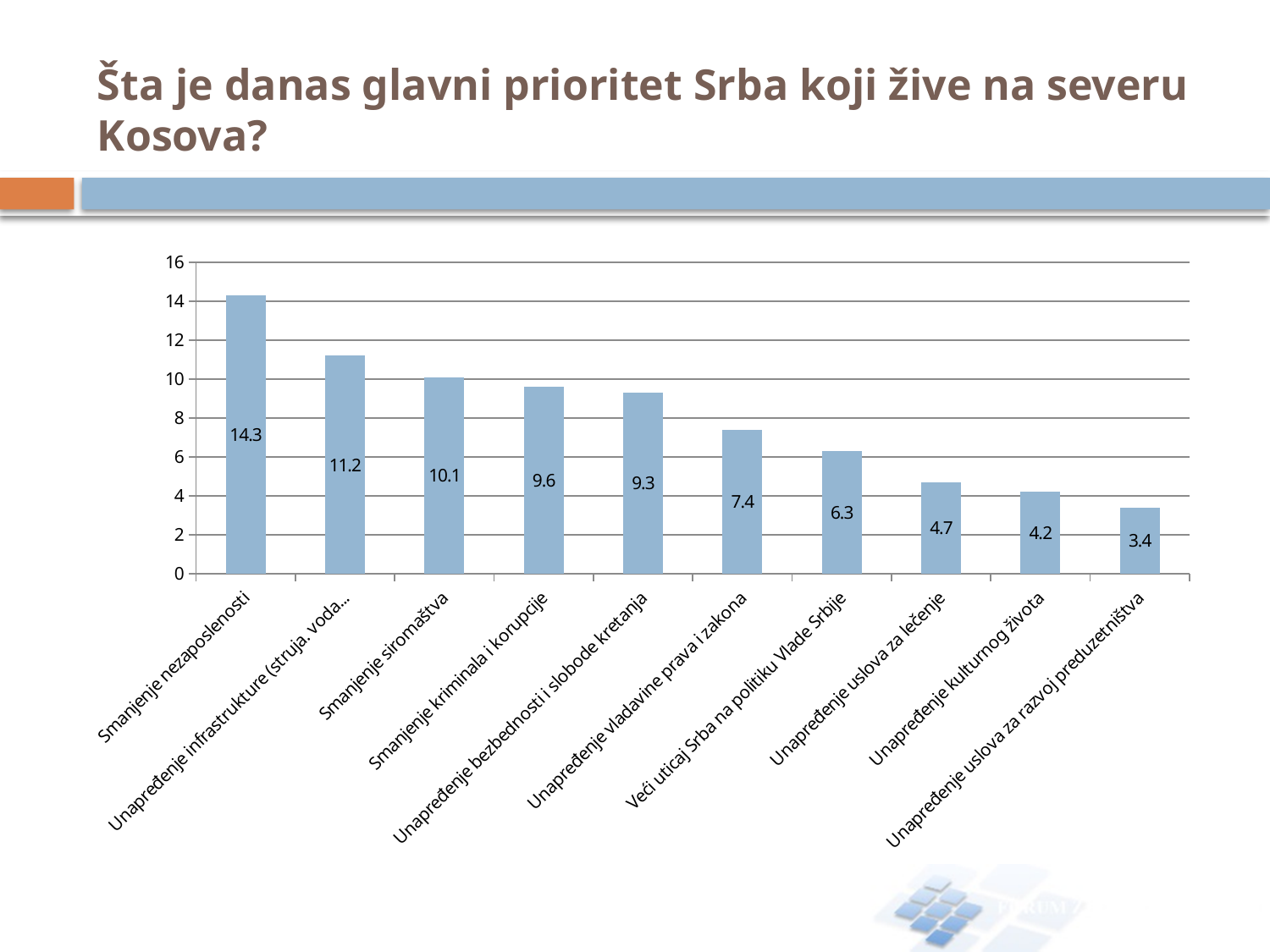
Which category has the lowest value? Unapređenje uslova za razvoj preduzetništva What is the value for Smanjenje nezaposlenosti? 14.3 How many categories are shown in the chart? 10 Which is larger, the value for Smanjenje kriminala i korupcije or the value for Unapređenje vladavine prava i zakona? Smanjenje kriminala i korupcije What is the value for Smanjenje siromaštva? 10.1 What is the value for Unapređenje uslova za lečenje? 4.7 Do the values rise or fall from left to right along the x axis? fall What is the value for Veći uticaj Srba na politiku Vlade Srbije? 6.3 Is the value for Unapređenje bezbednosti i slobode kretanja greater or less than 8? greater What kind of chart is shown on the slide? bar chart Which category has the highest value? Smanjenje nezaposlenosti What is the difference between the values for Smanjenje nezaposlenosti and Unapređenje kulturnog života? 10.1